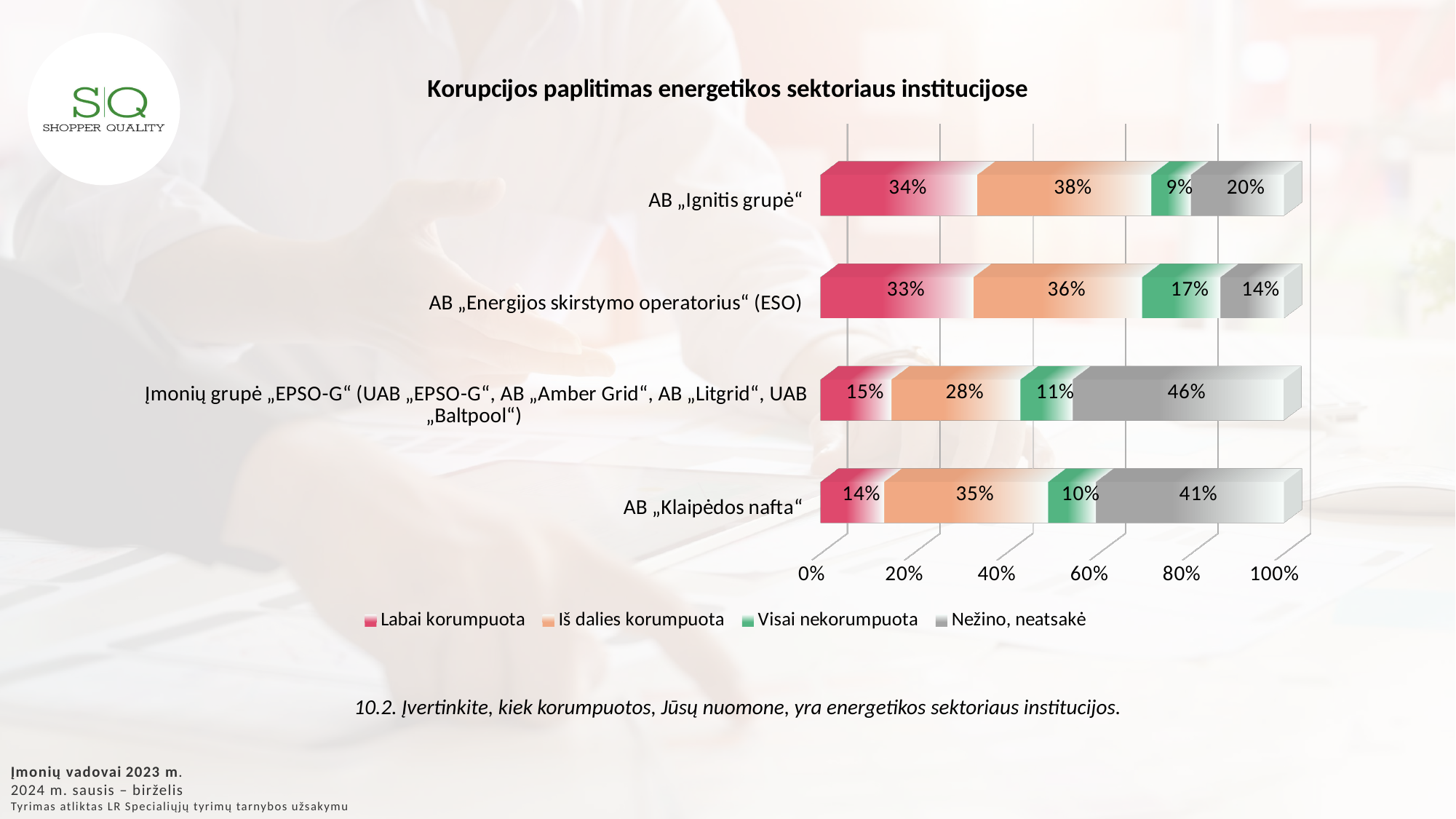
What is the total of the stacked bar for AB „Energijos skirstymo operatorius“ (ESO)? 100% What type of chart is shown on the slide? Stacked bar chart What is the „Visai nekorumpuota“ value for AB „Klaipėdos nafta“? 10% What percentage of respondents rated AB „Ignitis grupė“ as „Labai korumpuota“? 34% Which institution has the lowest „Labai korumpuota“ value? AB „Klaipėdos nafta“ How many series does the legend list? 4 How many percentage points higher is the „Iš dalies korumpuota“ value for AB „Ignitis grupė“ than for AB „Klaipėdos nafta“? 3 percentage points What is the „Nežino, neatsakė“ value for Įmonių grupė „EPSO-G“? 46% How many institutions are shown in the chart? 4 Which has a larger „Nežino, neatsakė“ value: AB „Klaipėdos nafta“ or Įmonių grupė „EPSO-G“? Įmonių grupė „EPSO-G“ What is the title of the chart? Korupcijos paplitimas energetikos sektoriaus institucijose Which institution has the highest „Visai nekorumpuota“ value? AB „Energijos skirstymo operatorius“ (ESO)